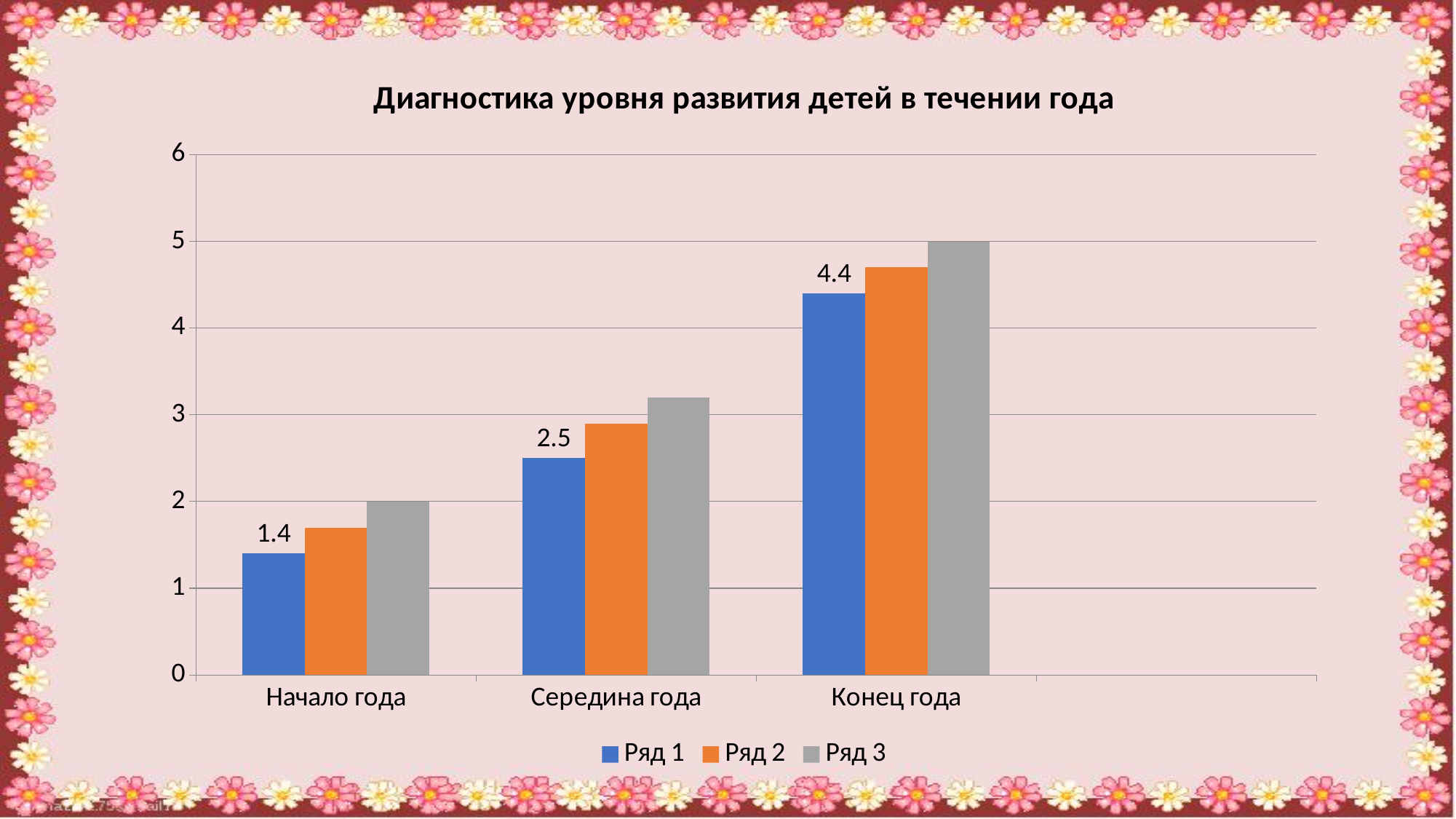
What is the value of Ряд 1 for Начало года? 1.4 Is the value of Ряд 2 for Конец года greater or less than 4? greater How many series does the legend list? 3 For Ряд 1, which category has the highest value? Конец года What is the value of Ряд 1 for Середина года? 2.5 Do the Ряд 1 values rise or fall from Начало года to Конец года? rise Is the value of Ряд 2 for Начало года greater or less than 2? less For Ряд 1, which is larger: Середина года or Конец года? Конец года What is the difference between the Ряд 1 values for Конец года and Начало года? 3 What is the value of Ряд 1 for Конец года? 4.4 For Ряд 1, which category has the lowest value? Начало года How many categories are shown on the x axis? 3